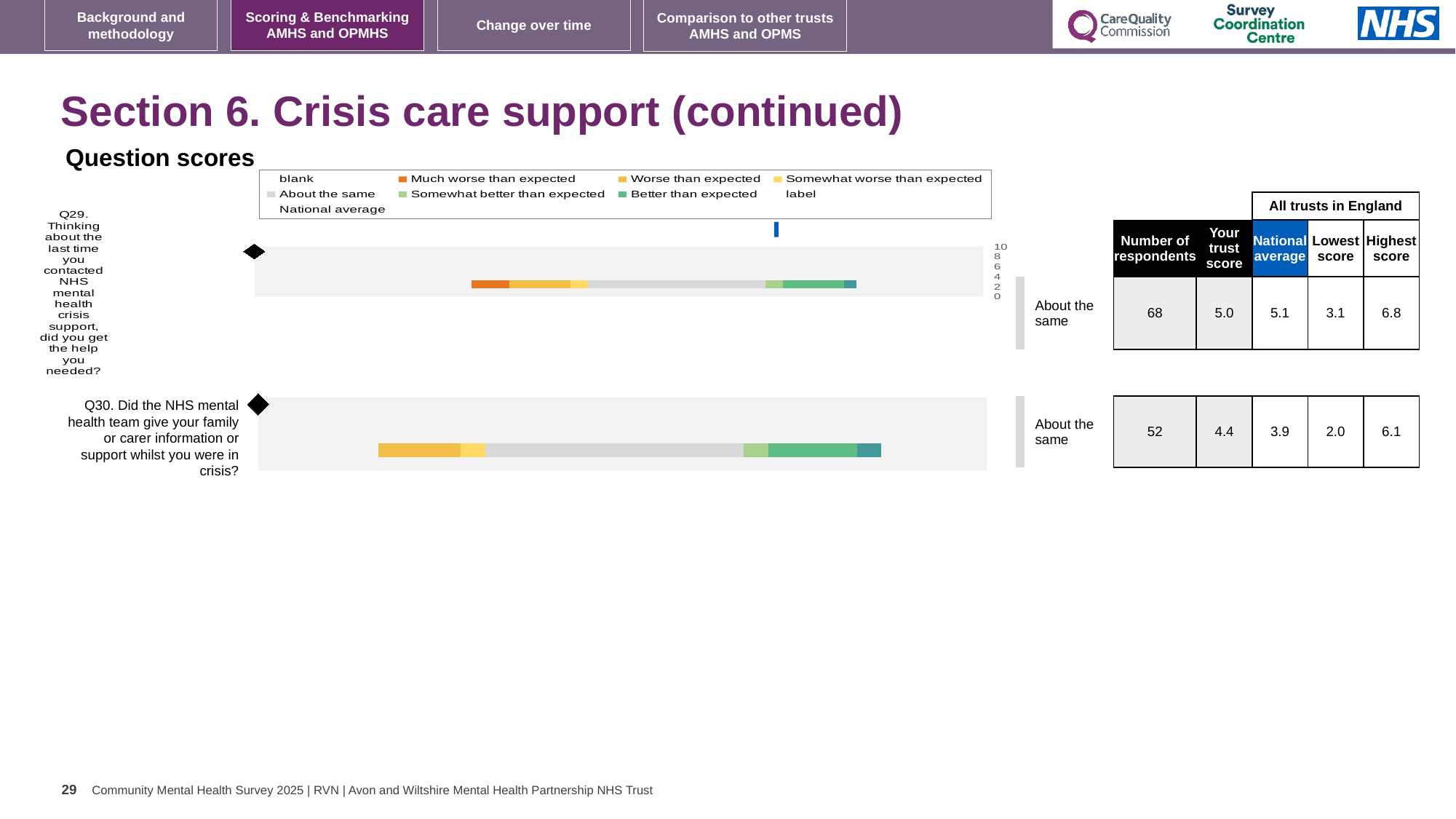
Which colour does the legend use for 'Much worse than expected'? Orange For Q30 (information or support for family or carer), what is the national average score? 3.9 For Q30, what is the highest score among all trusts in England? 6.1 For Q30, what is the difference between the highest score and the lowest score? 4.1 For Q29, what is the trust's score? 5.0 For Q29, what is the lowest score among all trusts in England? 3.1 For Q30, which is larger: the trust's score or the national average? The trust's score (4.4) For Q29 (did you get the help you needed?), how many respondents are shown? 68 What benchmark category is shown next to the Q29 chart? About the same For Q29, what is the difference between the national average and the trust's score? 0.1 What kind of chart is used to show the question scores? Bar chart How many questions are charted on this slide? 2